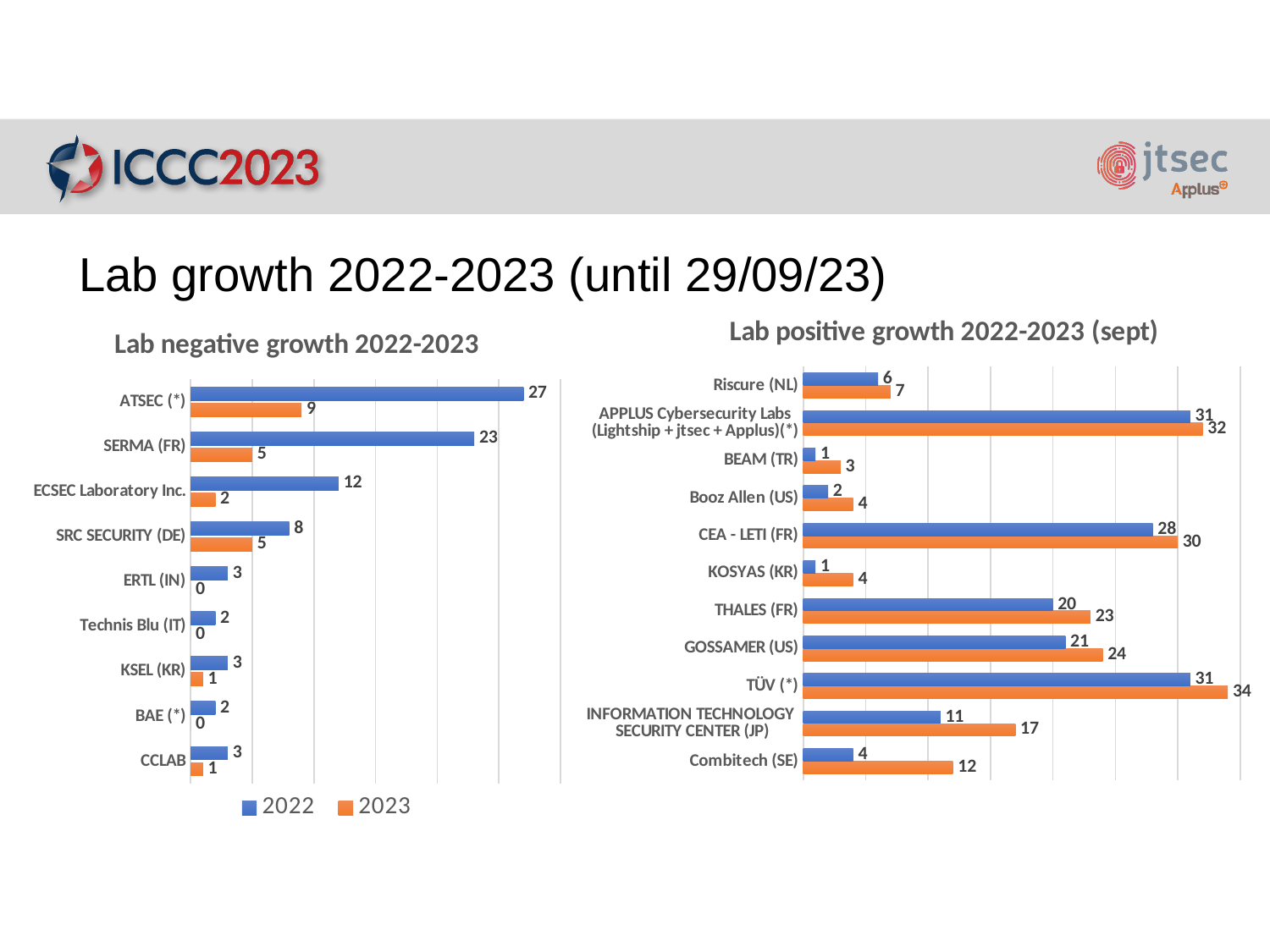
In the 'Lab positive growth 2022-2023 (sept)' chart, what is the difference between the 2023 and 2022 values for Combitech (SE)? 8 What type of chart is the 'Lab positive growth 2022-2023 (sept)' chart? Bar chart In the 'Lab negative growth 2022-2023' chart, what is the difference between the 2022 and 2023 values for ECSEC Laboratory Inc.? 10 How many labs are listed in the 'Lab negative growth 2022-2023' chart? 9 In the 'Lab negative growth 2022-2023' chart, which lab has the highest 2022 value? ATSEC (*) In the 'Lab negative growth 2022-2023' chart, what is the 2022 value for ATSEC (*)? 27 How many series does the legend of the 'Lab negative growth 2022-2023' chart list? 2 In the 'Lab negative growth 2022-2023' chart, what is the 2023 value for SERMA (FR)? 5 In the 'Lab positive growth 2022-2023 (sept)' chart, which lab has the highest orange (2023) value? TÜV (*) In the 'Lab positive growth 2022-2023 (sept)' chart, what is the orange (2023) value for TÜV (*)? 34 How many labs are listed in the 'Lab positive growth 2022-2023 (sept)' chart? 11 In the 'Lab positive growth 2022-2023 (sept)' chart, which is larger: the 2023 value for CEA - LETI (FR) or the 2023 value for GOSSAMER (US)? CEA - LETI (FR)